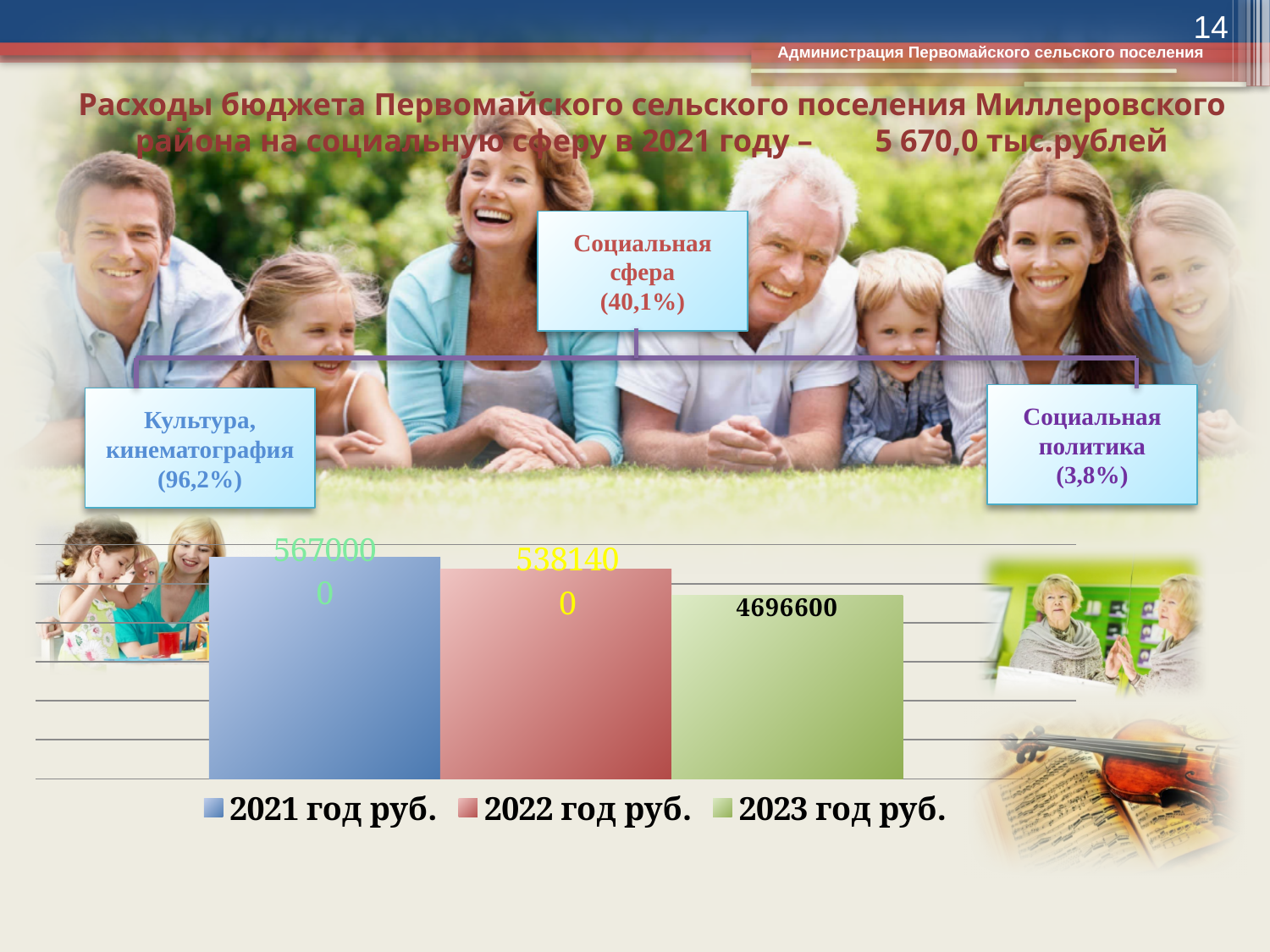
How many series does the chart legend list? 3 Which is larger, the value for 2022 год руб. or 2023 год руб.? 2022 год руб. Do the values rise or fall from 2021 to 2023? fall What is the value for 2021 год руб.? 5670000 What is the value for 2022 год руб.? 5381400 Which year has the highest value in the chart? 2021 год руб. What is the difference between the values for 2021 год руб. and 2023 год руб.? 973400 How many bars are plotted in the chart? 3 What is the value for 2023 год руб.? 4696600 What is the difference between the values for 2021 год руб. and 2022 год руб.? 288600 What kind of chart is shown on the slide? bar chart Which year has the lowest value in the chart? 2023 год руб.